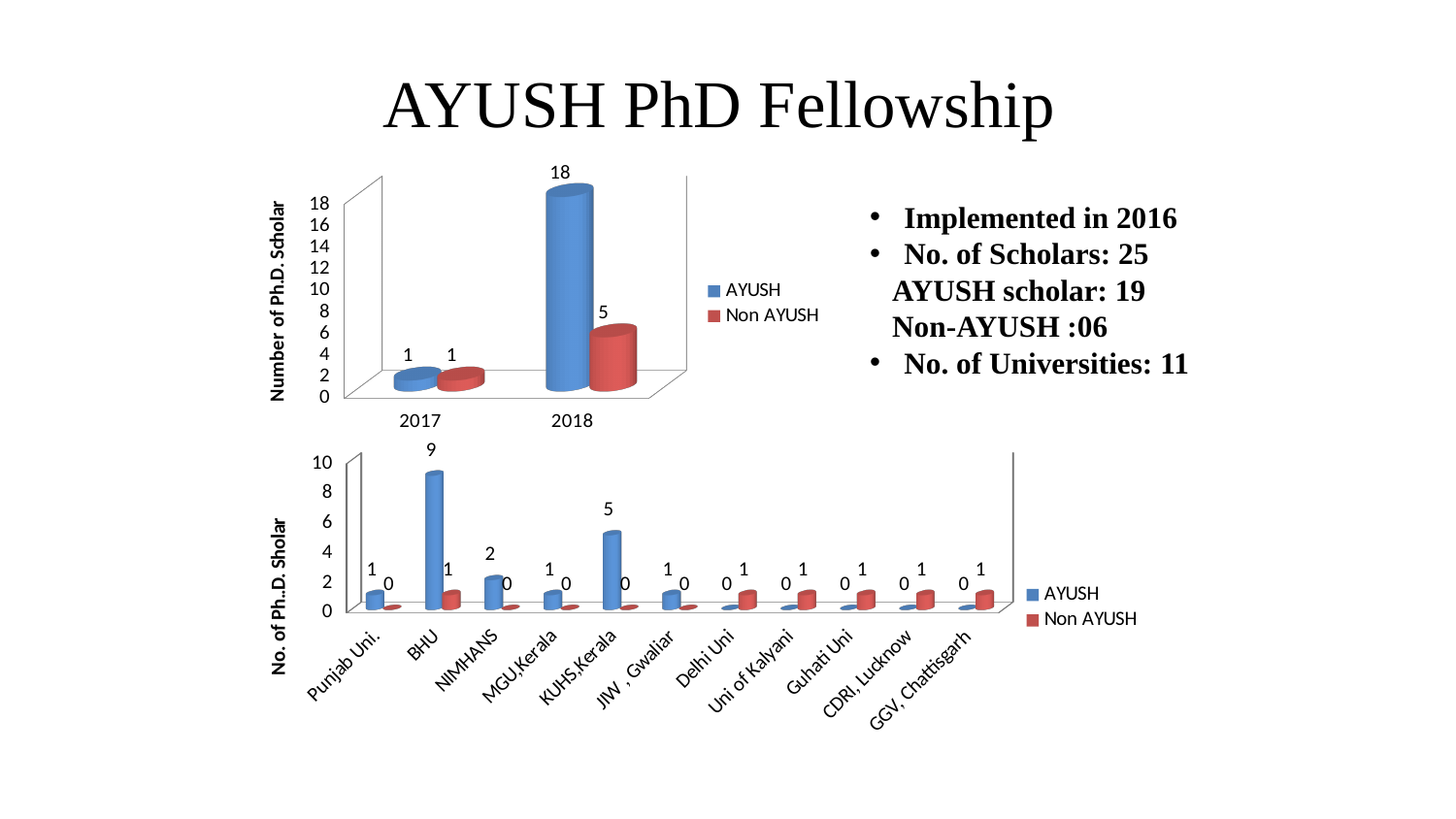
In the bottom chart (by university), what is the Non AYUSH value for BHU? 1 In the top chart (by year), what is the AYUSH value for 2018? 18 In the bottom chart (by university), how many universities are shown on the x axis? 11 In the bottom chart (by university), what is the AYUSH value for KUHS,Kerala? 5 What kind of chart is the bottom chart (by university)? bar chart In the top chart (by year), what is the Non AYUSH value for 2018? 5 In the bottom chart (by university), what is the difference between the AYUSH values for BHU and KUHS,Kerala? 4 In the top chart (by year), how many series does the legend list? 2 In the bottom chart (by university), which university has the highest AYUSH value? BHU In the top chart (by year), what is the difference between the AYUSH and Non AYUSH values for 2018? 13 In the bottom chart (by university), which is larger: the AYUSH value for BHU or the AYUSH value for NIMHANS? BHU In the top chart (by year), do the AYUSH values rise or fall from 2017 to 2018? rise